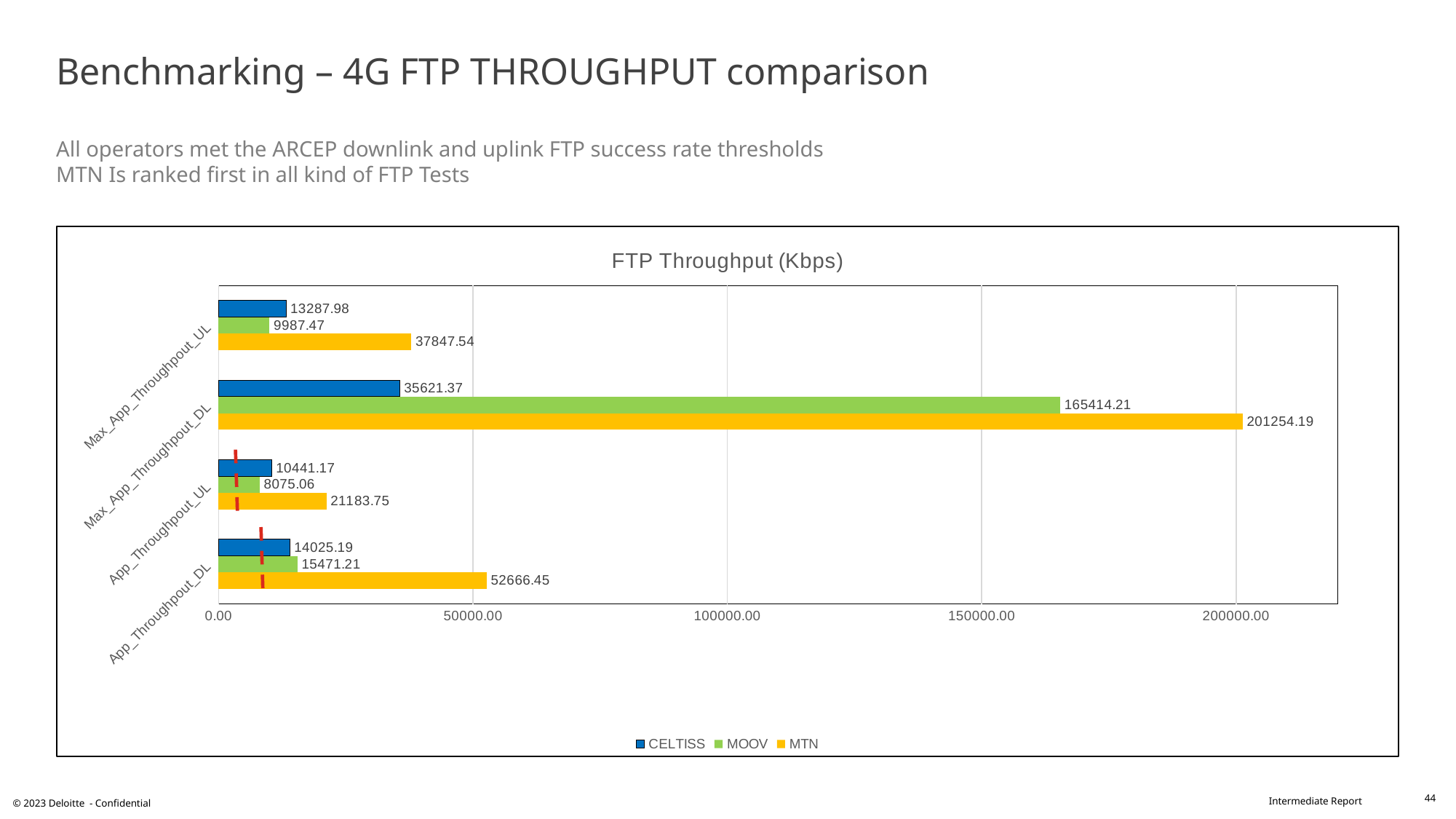
What is the MOOV value for App_Throughpout_UL? 8075.06 What is the MTN value for Max_App_Throughpout_DL? 201254.19 Which operator has the lowest value for Max_App_Throughpout_DL? CELTISS How many series does the legend list? 3 How many categories are shown on the vertical axis? 4 Which is larger for App_Throughpout_DL, the CELTISS value or the MOOV value? MOOV What is the difference between the MTN and MOOV values for Max_App_Throughpout_DL? 35839.98 What is the CELTISS value for App_Throughpout_DL? 14025.19 What kind of chart is shown on the slide? Bar chart Which operator has the highest value for Max_App_Throughpout_UL? MTN Is the MTN value for App_Throughpout_DL greater or less than 50000.00? greater What is the title of the chart? FTP Throughput (Kbps)